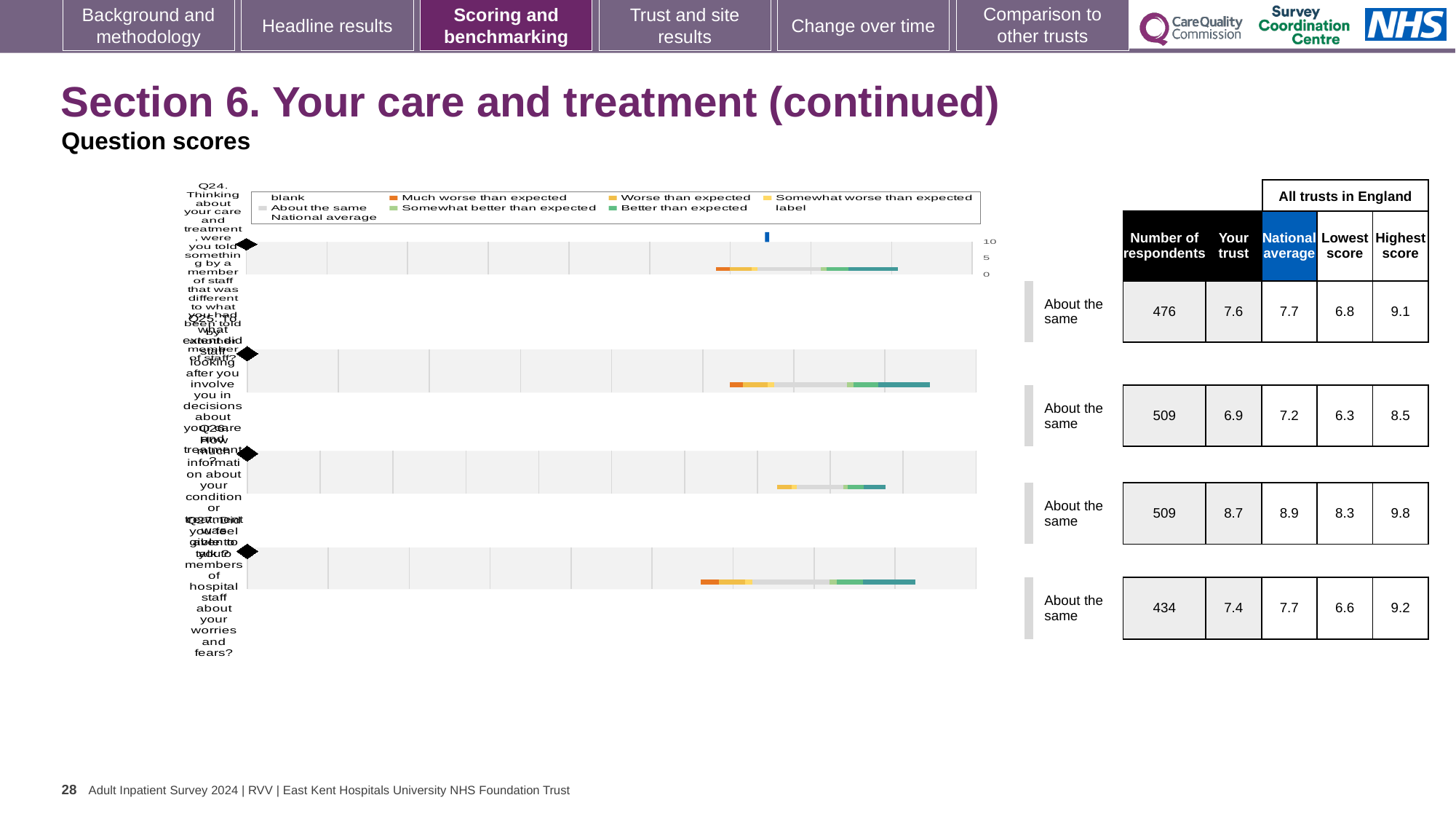
For the first chart (Q24), what is the difference between the national average and the 'Your trust' score? 0.1 For the fourth chart (Q27), which is larger: the 'Your trust' score or the national average? national average How many question charts are shown on the slide? 4 Which of the four charts has the lowest 'Your trust' score? the second chart (Q25), 6.9 For the fourth chart (Q27), what is the lowest score among all trusts in England? 6.6 For the third chart (Q26), how many respondents are listed? 509 Which of the four charts has the highest 'Your trust' score? the third chart (Q26), 8.7 What benchmark category is shown next to each of the four charts? About the same For the second chart (Q25), what is the national average score? 7.2 For the first chart (Q24), what is the 'Your trust' score shown in the table? 7.6 For the fourth chart (Q27), what is the highest score among all trusts in England? 9.2 What kind of chart is used for each question on the slide? bar chart